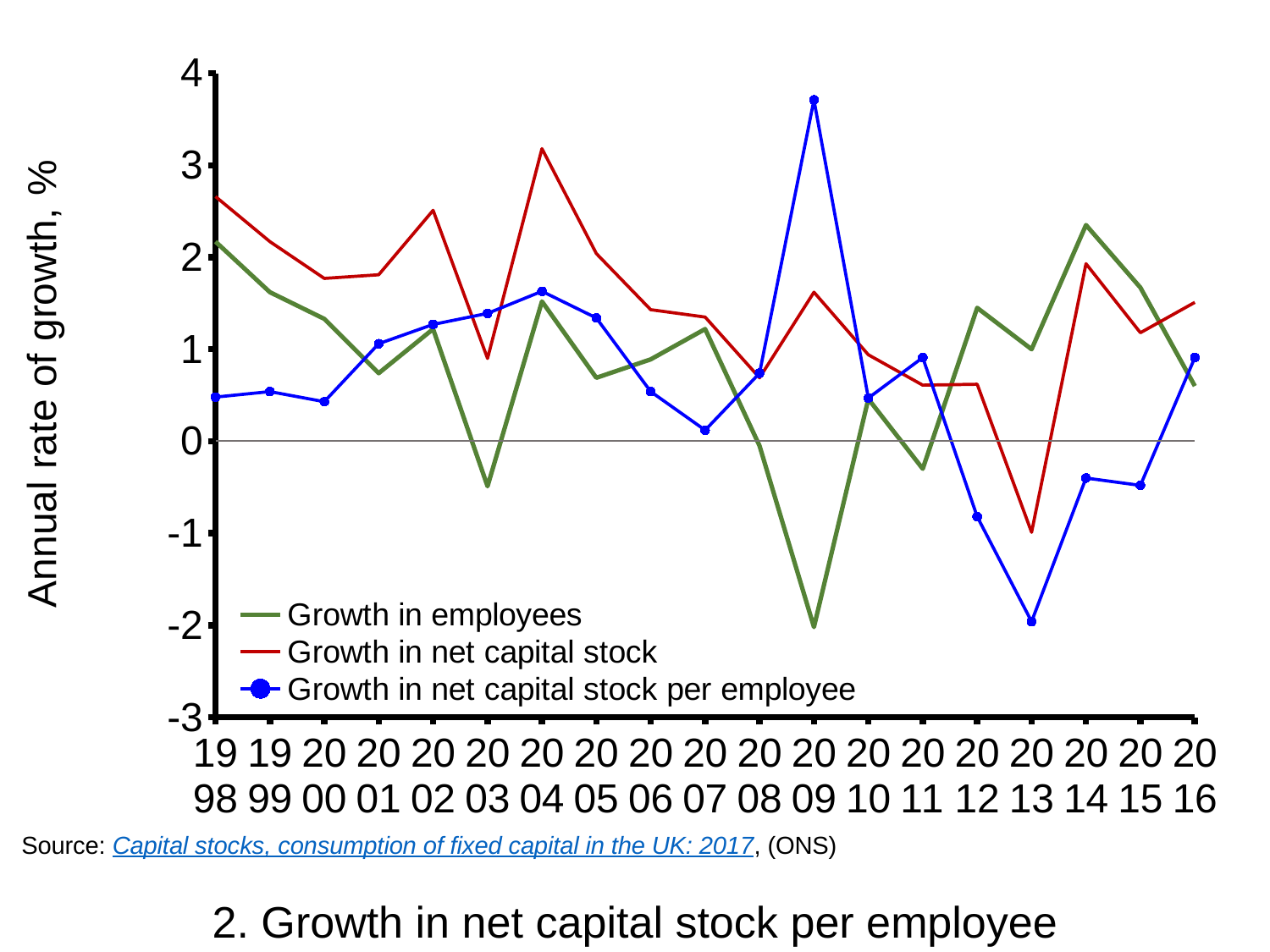
Does 'Growth in net capital stock' rise or fall from 2004 to 2007? Fall Is the value of 'Growth in net capital stock per employee' in 2009 greater or less than 3? greater In which year does the 'Growth in net capital stock per employee' series reach its highest value? 2009 In which year does 'Growth in net capital stock' reach its highest value? 2004 What is the label on the y axis? Annual rate of growth, % In 2004, which is larger: 'Growth in net capital stock' or 'Growth in employees'? Growth in net capital stock In which year does the 'Growth in net capital stock per employee' series reach its lowest value? 2013 What kind of chart is shown on the slide? Line chart In which year is 'Growth in employees' at its lowest? 2009 How many series does the legend list? 3 Is the value of 'Growth in employees' in 2009 greater or less than -1? less How many years are plotted along the x axis? 19